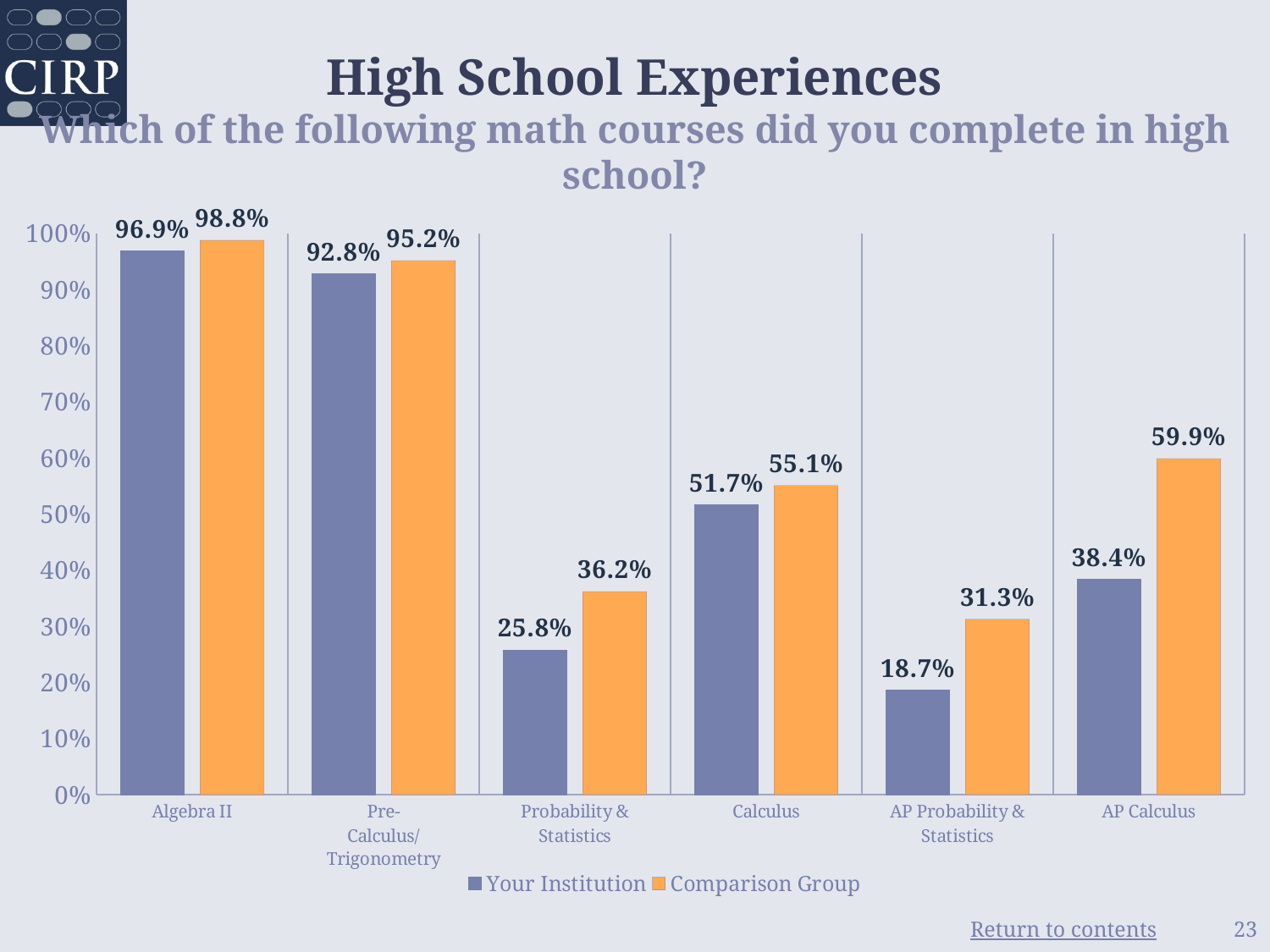
Which math course has the highest value for the Comparison Group? Algebra II How many math courses are shown on the x axis? 6 What is the difference between the Comparison Group and Your Institution values for Calculus? 3.4% How many series does the legend list? 2 What is the value for the Comparison Group for AP Calculus? 59.9% What kind of chart is shown on the slide? Bar chart Is the value for Your Institution for Pre-Calculus/Trigonometry greater or less than 90%? greater What is the value for Your Institution for Algebra II? 96.9% What is the value for Your Institution for AP Probability & Statistics? 18.7% What is the difference between the Comparison Group and Your Institution values for AP Calculus? 21.5% For Probability & Statistics, which is larger: Your Institution or the Comparison Group? Comparison Group Which math course has the lowest value for Your Institution? AP Probability & Statistics